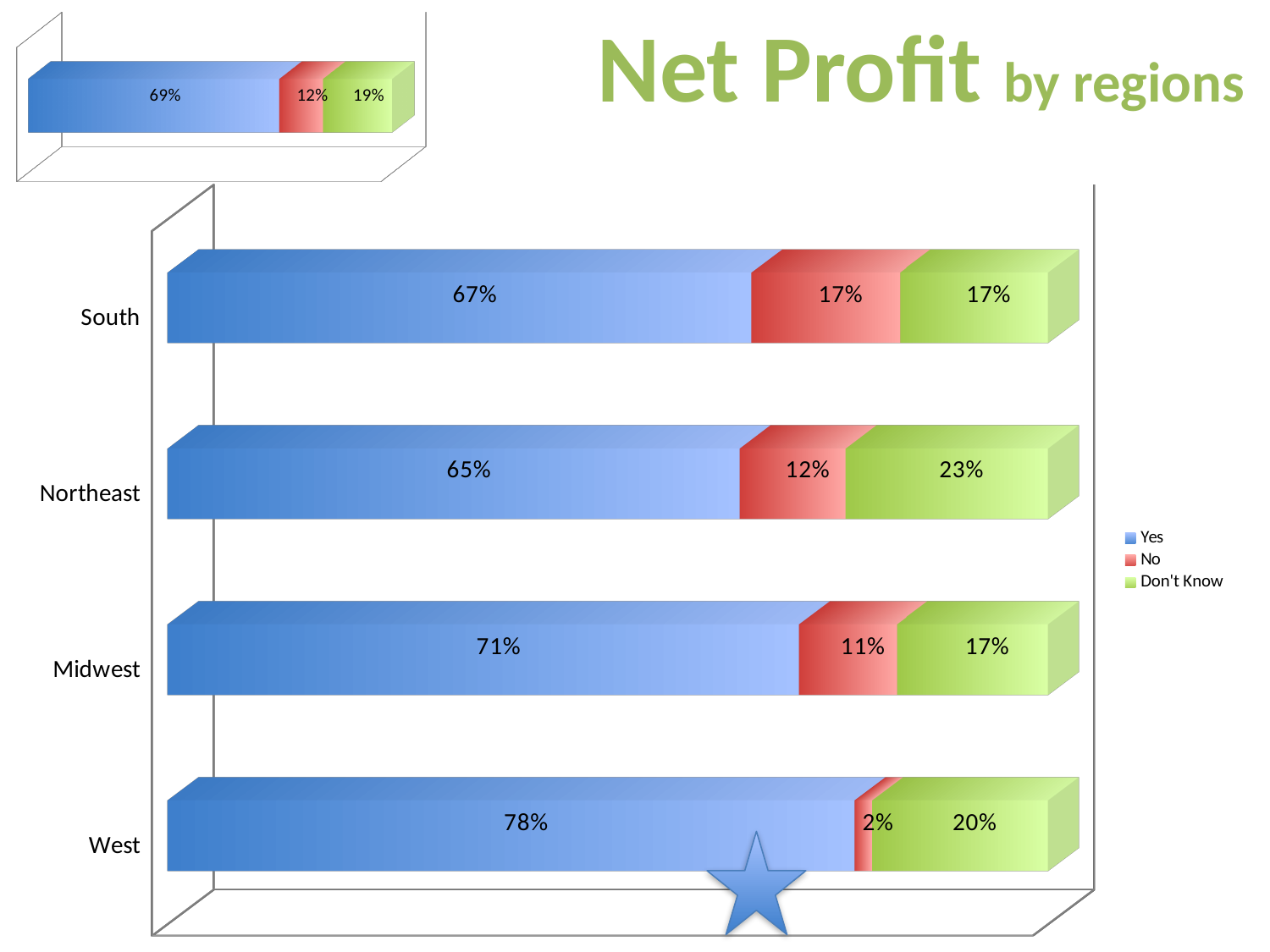
In the Net Profit by regions chart, how many series does the legend list? 3 In the Net Profit by regions chart, what is the No value for Northeast? 12% In the small chart at the top left of the slide, what is the value of the red segment? 12% In the Net Profit by regions chart, which region has the highest Yes value? West In the Net Profit by regions chart, how many regions are shown? 4 In the Net Profit by regions chart, what is the difference between the Yes values for West and Northeast? 13 percentage points In the Net Profit by regions chart, what is the Yes value for West? 78% In the Net Profit by regions chart, which region has the larger No value, South or Midwest? South In the Net Profit by regions chart, which region has the highest Don't Know value? Northeast In the Net Profit by regions chart, what is the Don't Know value for Midwest? 17% In the Net Profit by regions chart, what is the total of the Northeast bar? 100% In the Net Profit by regions chart, which region has the lowest No value? West